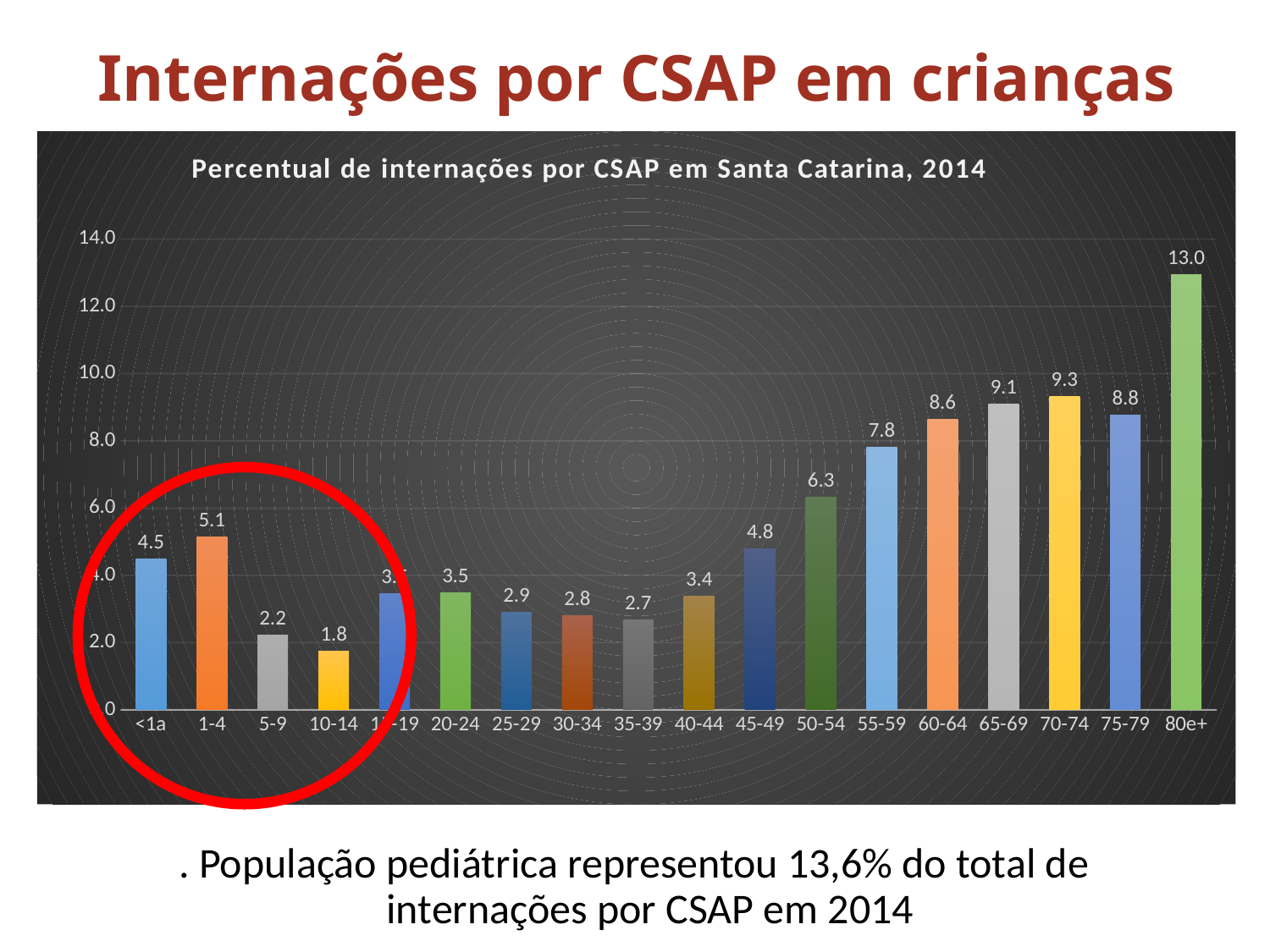
Which is larger, the value for 70-74 or the value for 75-79? 70-74 Do the values rise or fall from the 35-39 age group to the 80e+ age group? Rise Is the value for the 60-64 age group greater or less than 8.0? greater Which age group has the lowest percentage of hospitalizations? 10-14 What is the value for the 1-4 age group? 5.1 What is the value for the 55-59 age group? 7.8 What kind of chart is shown on the slide? Bar chart What is the value for the 80e+ age group? 13.0 What is the difference between the values for the 1-4 and <1a age groups? 0.6 What is the title of the chart? Percentual de internações por CSAP em Santa Catarina, 2014 Which age group has the highest percentage of hospitalizations? 80e+ How many age groups are shown on the x axis? 18